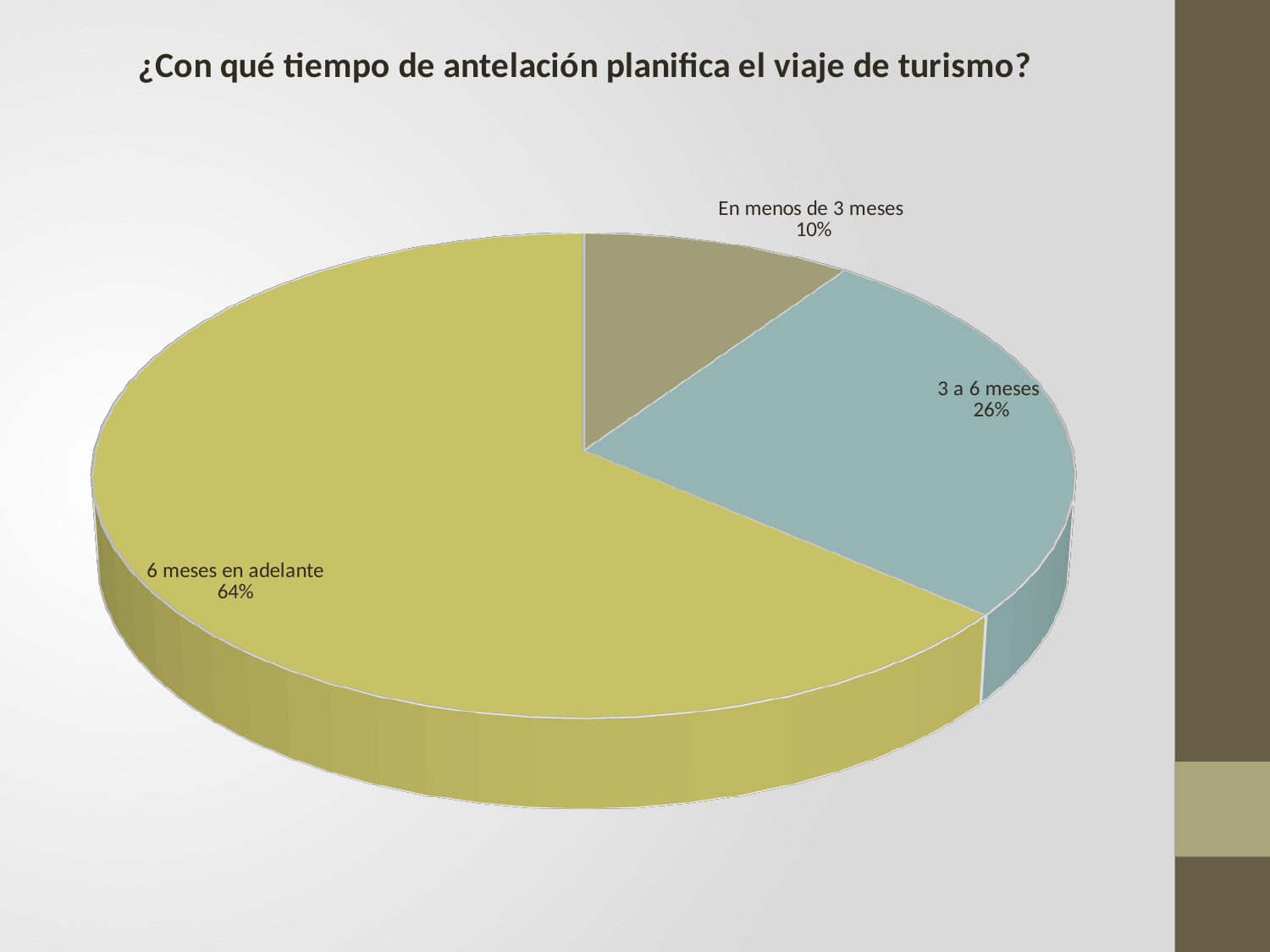
Which category has the smallest slice of the pie? En menos de 3 meses How many categories are shown in the pie chart? 3 What colour is the slice for "3 a 6 meses"? Blue-grey (teal) Which category has the largest slice of the pie? 6 meses en adelante What is the title of the chart? ¿Con qué tiempo de antelación planifica el viaje de turismo? What is the difference in percentage points between "3 a 6 meses" and "En menos de 3 meses"? 16 What is the value shown for "3 a 6 meses"? 26% What is the difference in percentage points between "6 meses en adelante" and "3 a 6 meses"? 38 What share of the pie does "6 meses en adelante" represent? 64% What is the value shown for "En menos de 3 meses"? 10% What kind of chart is shown on the slide? Pie chart Which is larger, the slice for "3 a 6 meses" or the slice for "En menos de 3 meses"? 3 a 6 meses